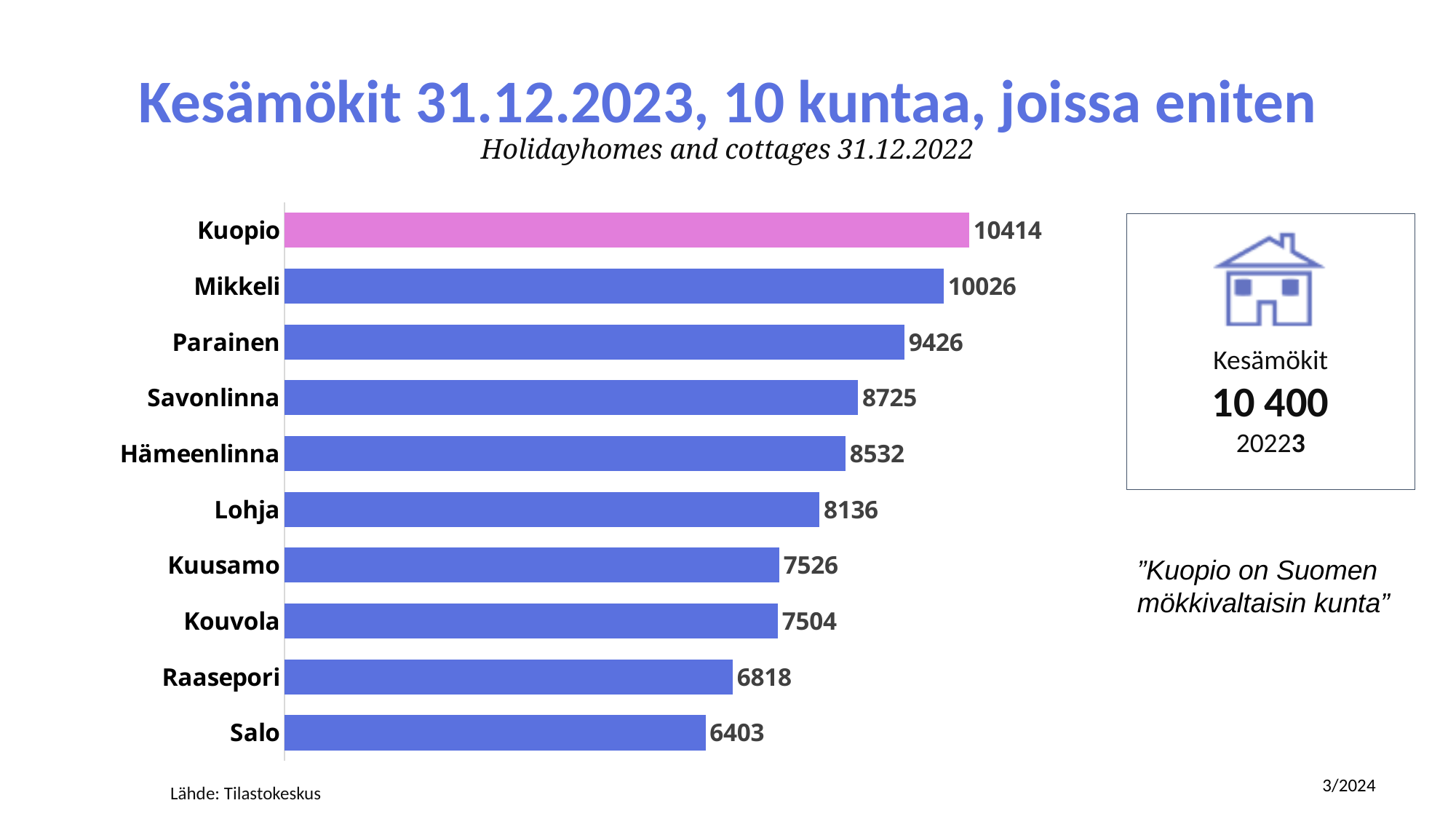
What is the difference between the values for Lohja and Salo? 1733 What is the value for Savonlinna? 8725 How many municipalities are shown in the chart? 10 Which municipality has the lowest value? Salo What kind of chart is shown on the slide? Bar chart What is the source given below the chart? Tilastokeskus Which municipality has the highest value? Kuopio What is the value for Kuopio? 10414 What is the value for Raasepori? 6818 What is the difference between the values for Kuopio and Mikkeli? 388 Which is larger, the value for Parainen or the value for Hämeenlinna? Parainen Which bar is coloured differently from the others? Kuopio